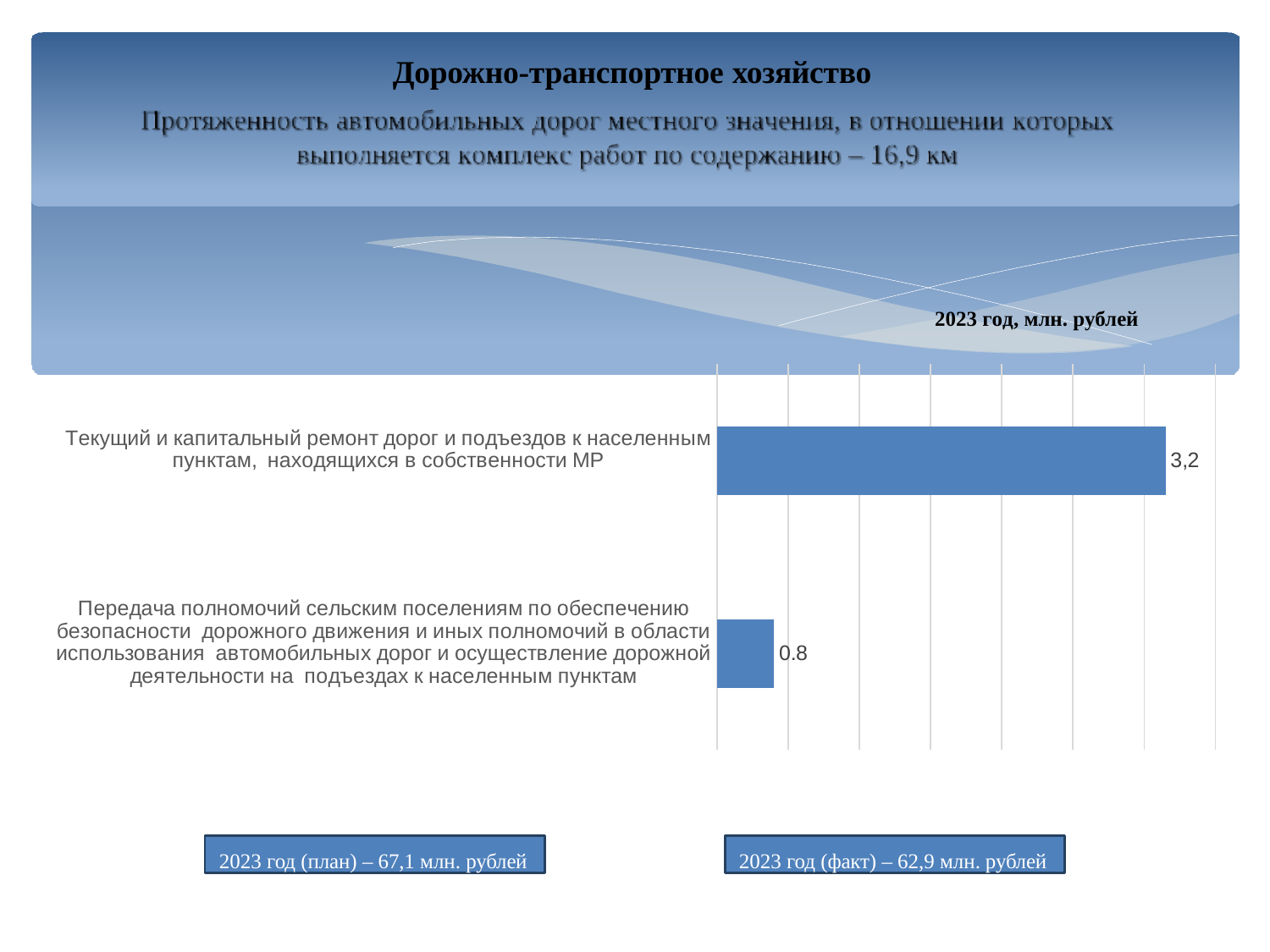
What kind of chart is shown on the slide? Bar chart What is the value for "Передача полномочий сельским поселениям по обеспечению безопасности дорожного движения и иных полномочий в области использования автомобильных дорог и осуществление дорожной деятельности на подъездах к населенным пунктам"? 0.8 Which is larger: the value for "Текущий и капитальный ремонт дорог..." or the value for "Передача полномочий сельским поселениям..."? Текущий и капитальный ремонт дорог и подъездов к населенным пунктам, находящихся в собственности МР How many categories are shown in the chart? 2 Which category has the highest value? Текущий и капитальный ремонт дорог и подъездов к населенным пунктам, находящихся в собственности МР What is the title of the chart? 2023 год, млн. рублей What is the difference between the value for "Текущий и капитальный ремонт дорог..." and the value for "Передача полномочий сельским поселениям..."? 2.4 What colour are the bars in the chart? Blue What is the value for "Текущий и капитальный ремонт дорог и подъездов к населенным пунктам, находящихся в собственности МР"? 3,2